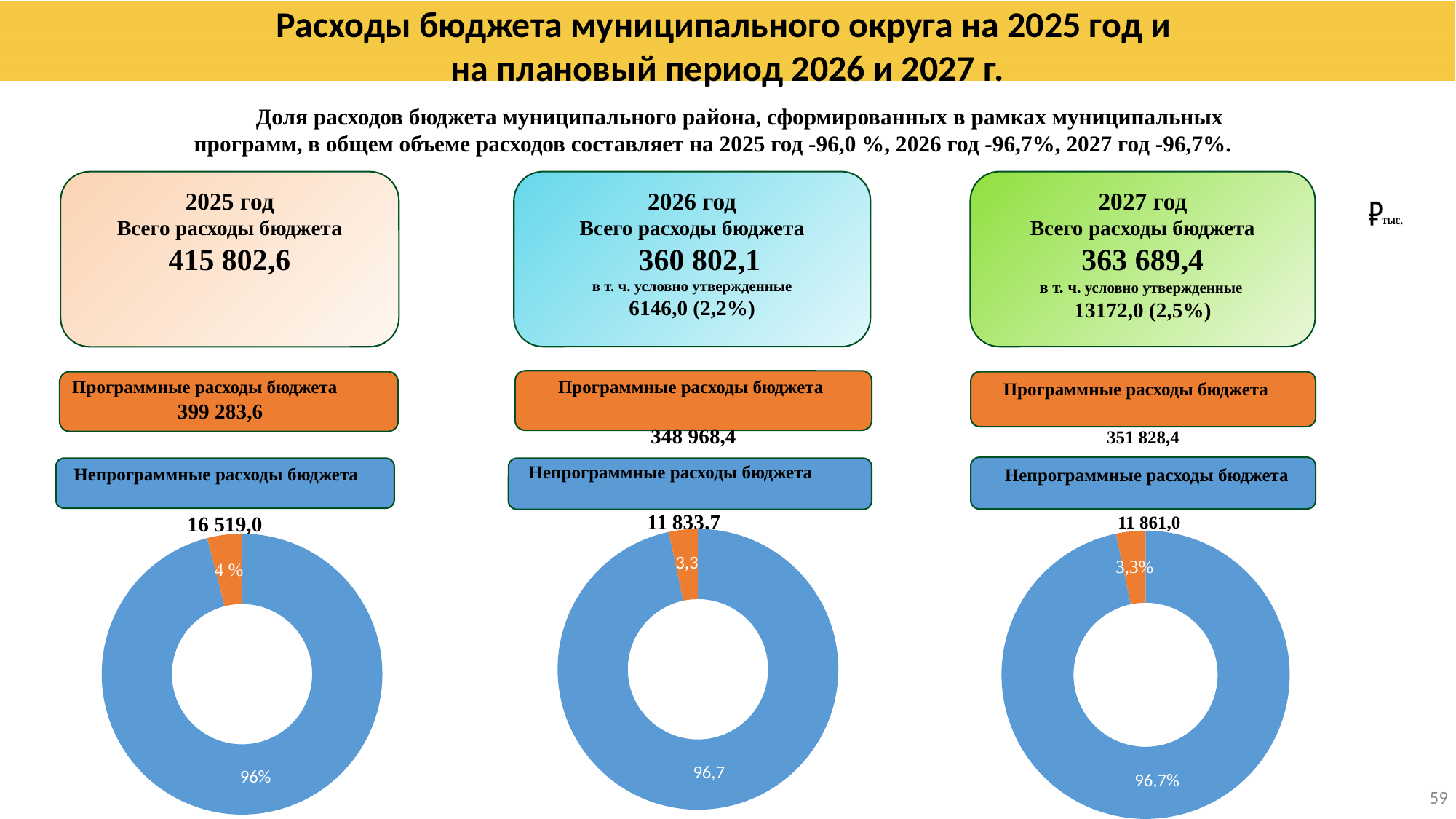
In the middle pie chart (2026 год), what value is printed on the small orange slice? 3,3 How many pie (donut) charts are shown on the slide? 3 In the right pie chart (2027 год), what colour is the largest slice? blue What kind of chart is shown under the 2025 год block on the left of the slide? doughnut chart How many slices does the left pie chart (2025 год) have? 2 In the right pie chart (2027 год), what percentage is printed on the small orange slice? 3,3% In the right pie chart (2027 год), what percentage is printed on the large blue slice? 96,7% In the left pie chart (2025 год), which slice is larger, the blue one or the orange one? the blue one In the left pie chart (2025 год), what percentage is printed on the small orange slice? 4 % In the left pie chart (2025 год), what is the difference between the blue slice's percentage and the orange slice's percentage? 92% In the left pie chart (2025 год), what percentage is printed on the large blue slice? 96% In the middle pie chart (2026 год), what value is printed on the large blue slice? 96,7